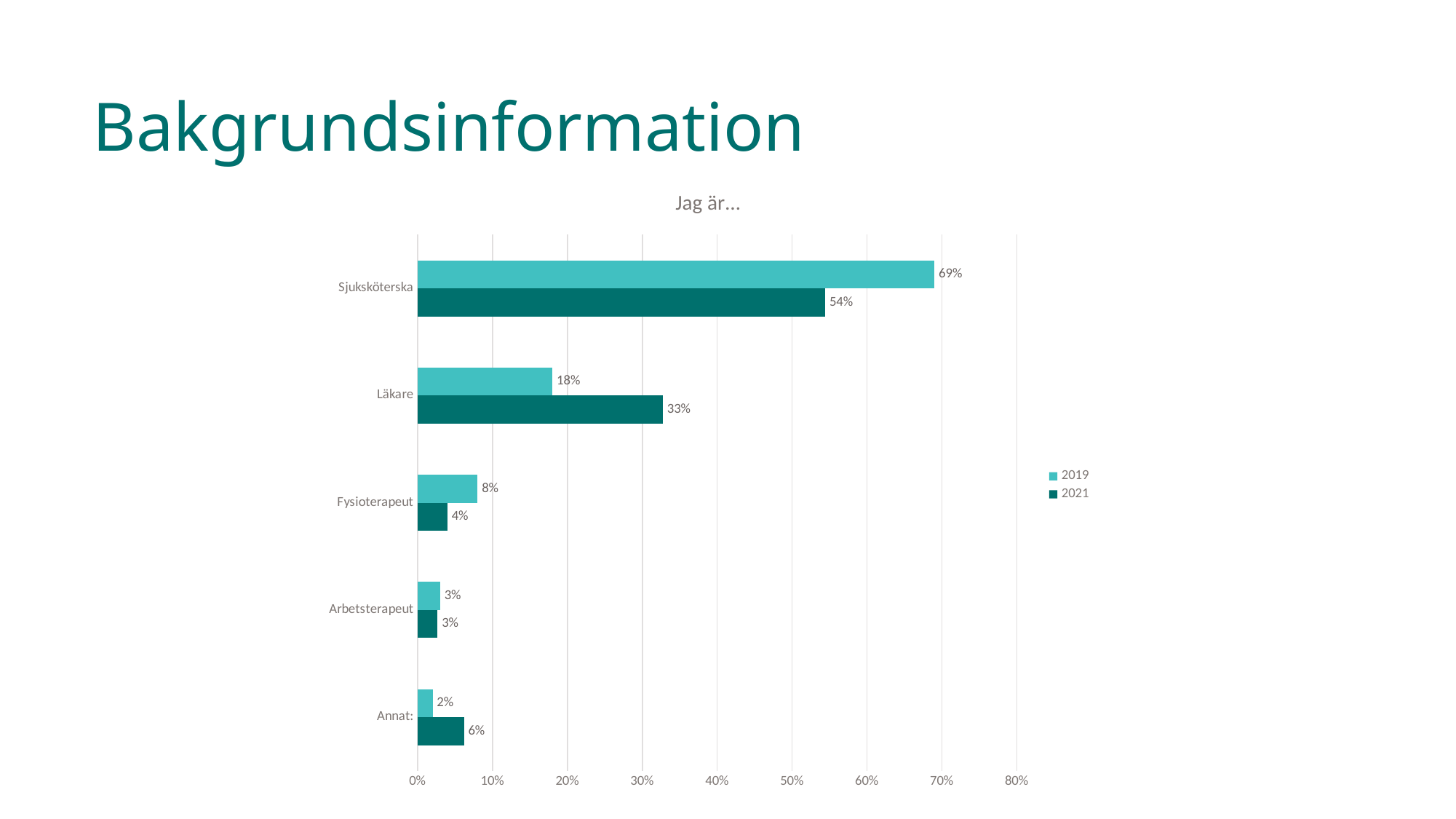
How many series does the legend list? 2 Which category has the lowest value in the 2019 series? Annat: Which category has the highest value in the 2021 series? Sjuksköterska What is the value for Läkare in the 2021 series? 33% What is the difference between the 2019 and 2021 values for Sjuksköterska? 15% What kind of chart is shown on the slide? Bar chart What is the value for Fysioterapeut in the 2021 series? 4% What is the title of the chart? Jag är… Which is larger for Läkare, the 2019 value or the 2021 value? 2021 What is the value for Sjuksköterska in the 2019 series? 69% What is the value for Annat: in the 2019 series? 2% How many categories are shown on the chart? 5